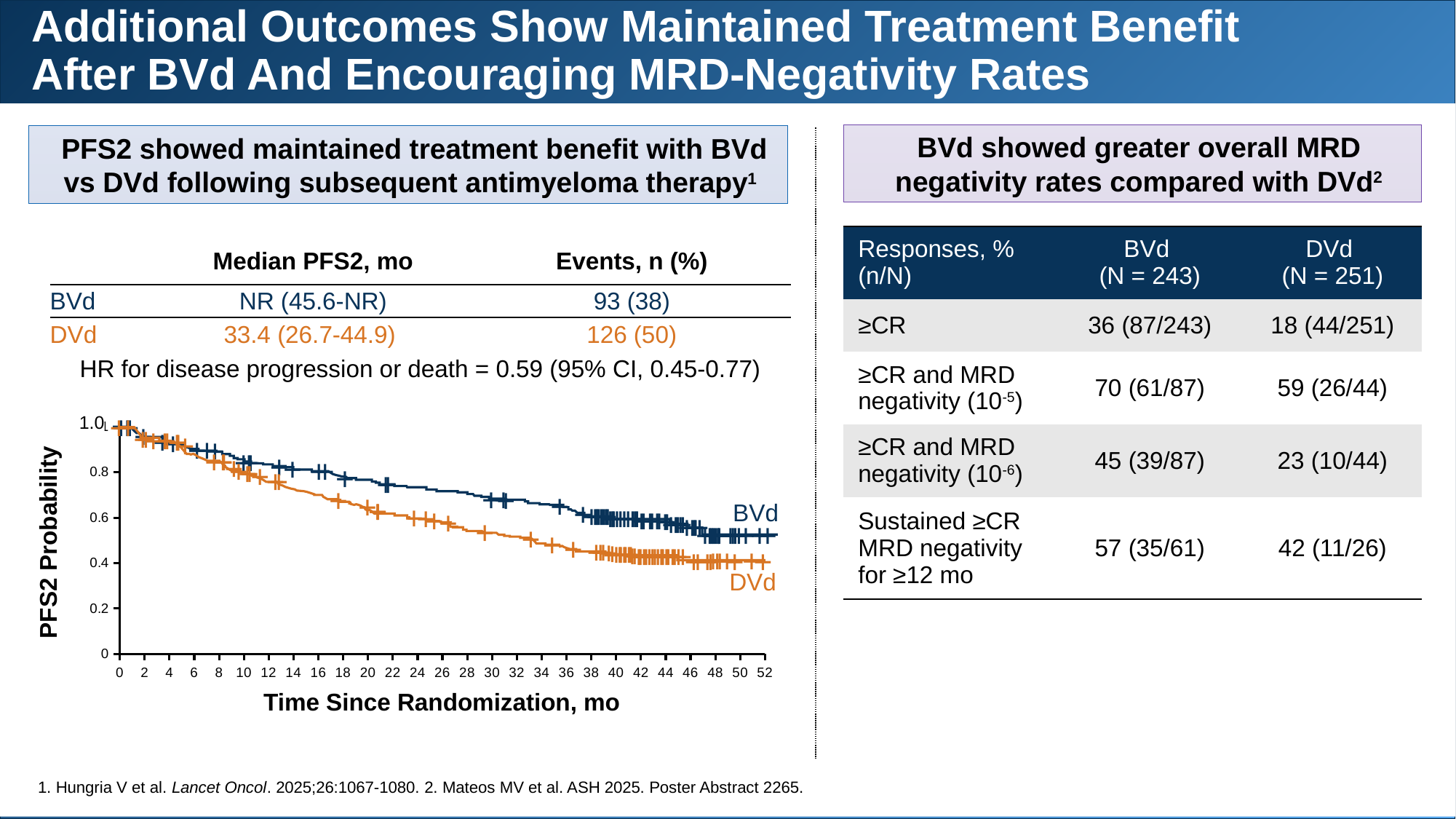
In the PFS2 probability chart, is the BVd curve at 52 months greater or less than 0.4? greater What is the y-axis label of the PFS2 probability chart? PFS2 Probability In the PFS2 probability chart, is the BVd curve at 20 months greater or less than 0.6? greater In the PFS2 probability chart, is the DVd curve at 30 months greater or less than 0.6? less According to the PFS2 table above the chart, what is the median PFS2 for DVd? 33.4 (26.7-44.9) What is the x-axis label of the PFS2 probability chart? Time Since Randomization, mo How many series (treatment arms) are plotted in the PFS2 probability chart? 2 In the PFS2 probability chart, do the curves rise or fall as time since randomization increases? fall What kind of chart is shown on the left side of the slide under the PFS2 table? line chart According to the PFS2 table above the chart, how many events, n (%), were reported for BVd? 93 (38) In the PFS2 probability chart, which curve is higher at 40 months, BVd or DVd? BVd